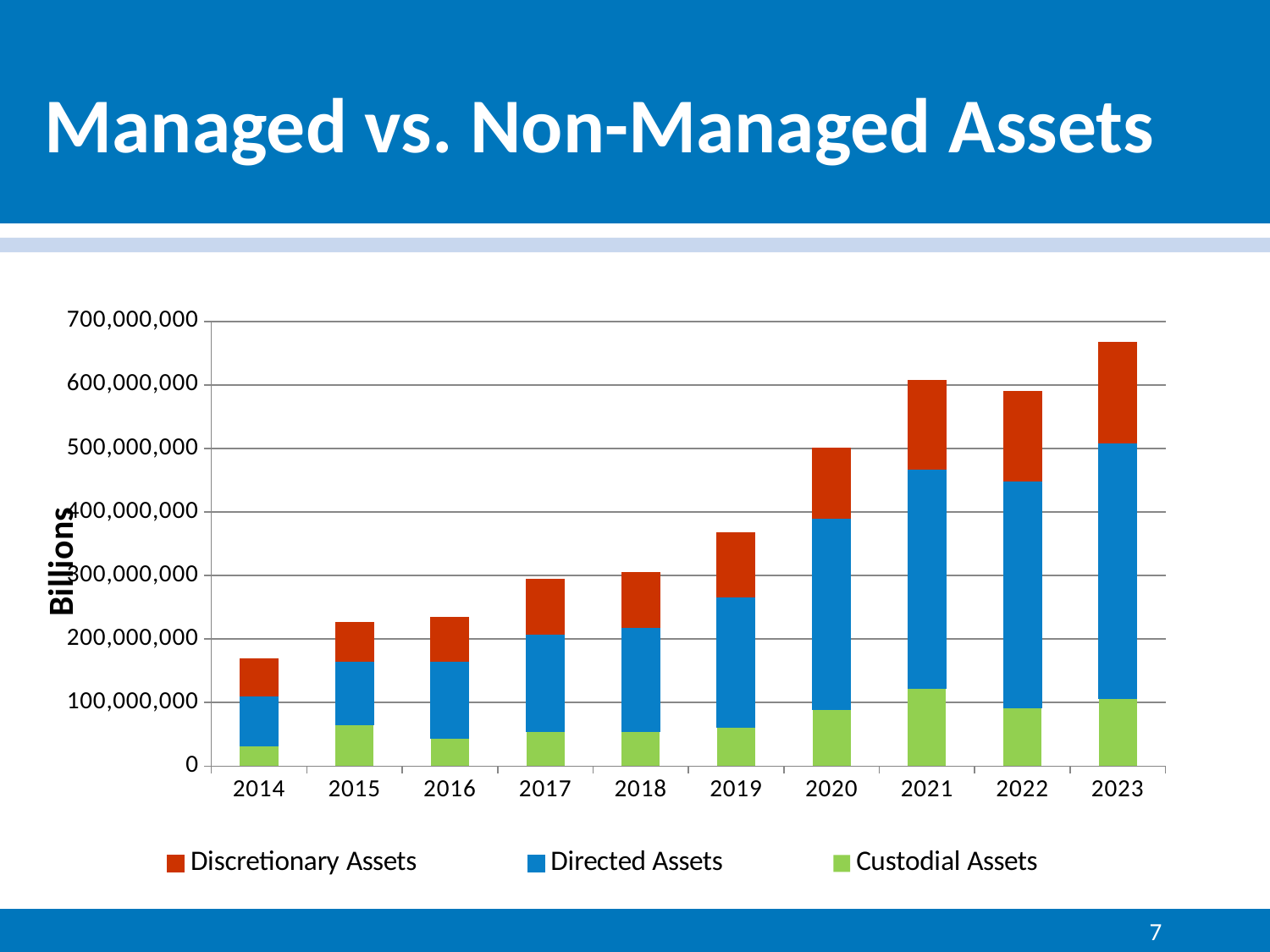
Which year has a larger total, 2019 or 2020? 2020 Which colour represents Directed Assets in the legend? Blue Is the total for 2019 greater or less than 400,000,000? less How many years are shown on the x axis? 10 Do the total stacked bars generally rise or fall from 2014 to 2023? Rise Is the total for 2023 greater or less than 600,000,000? greater What is the label on the vertical axis? Billions Is the total for 2014 greater or less than 200,000,000? less What kind of chart is shown on the slide? Stacked bar chart How many series does the legend list? 3 Which year has the highest total stacked bar? 2023 Which year has the lowest total stacked bar? 2014